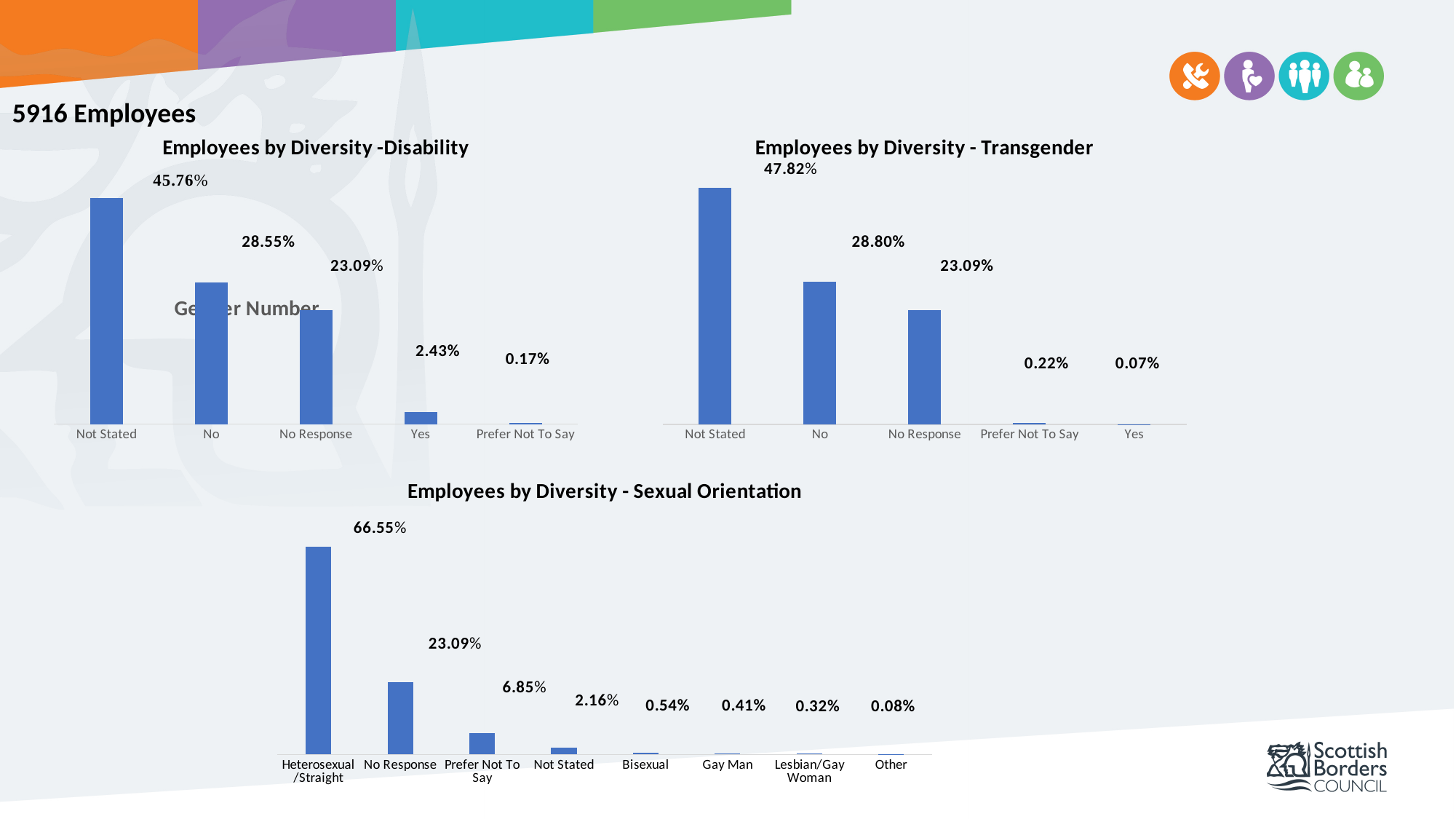
In the 'Employees by Diversity - Sexual Orientation' chart, what is the value for Bisexual? 0.54% What kind of chart is 'Employees by Diversity - Sexual Orientation'? Bar chart In the 'Employees by Diversity - Sexual Orientation' chart, which is larger, the value for Gay Man or the value for Lesbian/Gay Woman? Gay Man In the 'Employees by Diversity - Transgender' chart, what is the value for Yes? 0.07% In the 'Employees by Diversity -Disability' chart, what is the value for Yes? 2.43% In the 'Employees by Diversity -Disability' chart, what is the value for Not Stated? 45.76% In the 'Employees by Diversity - Sexual Orientation' chart, what is the value for Heterosexual/Straight? 66.55% In the 'Employees by Diversity - Sexual Orientation' chart, how many categories are shown on the x axis? 8 How many charts are shown on the slide? 3 In the 'Employees by Diversity - Transgender' chart, what is the value for Not Stated? 47.82% In the 'Employees by Diversity -Disability' chart, which category has the lowest value? Prefer Not To Say In the 'Employees by Diversity - Transgender' chart, what is the difference between the values for No and No Response? 5.71%